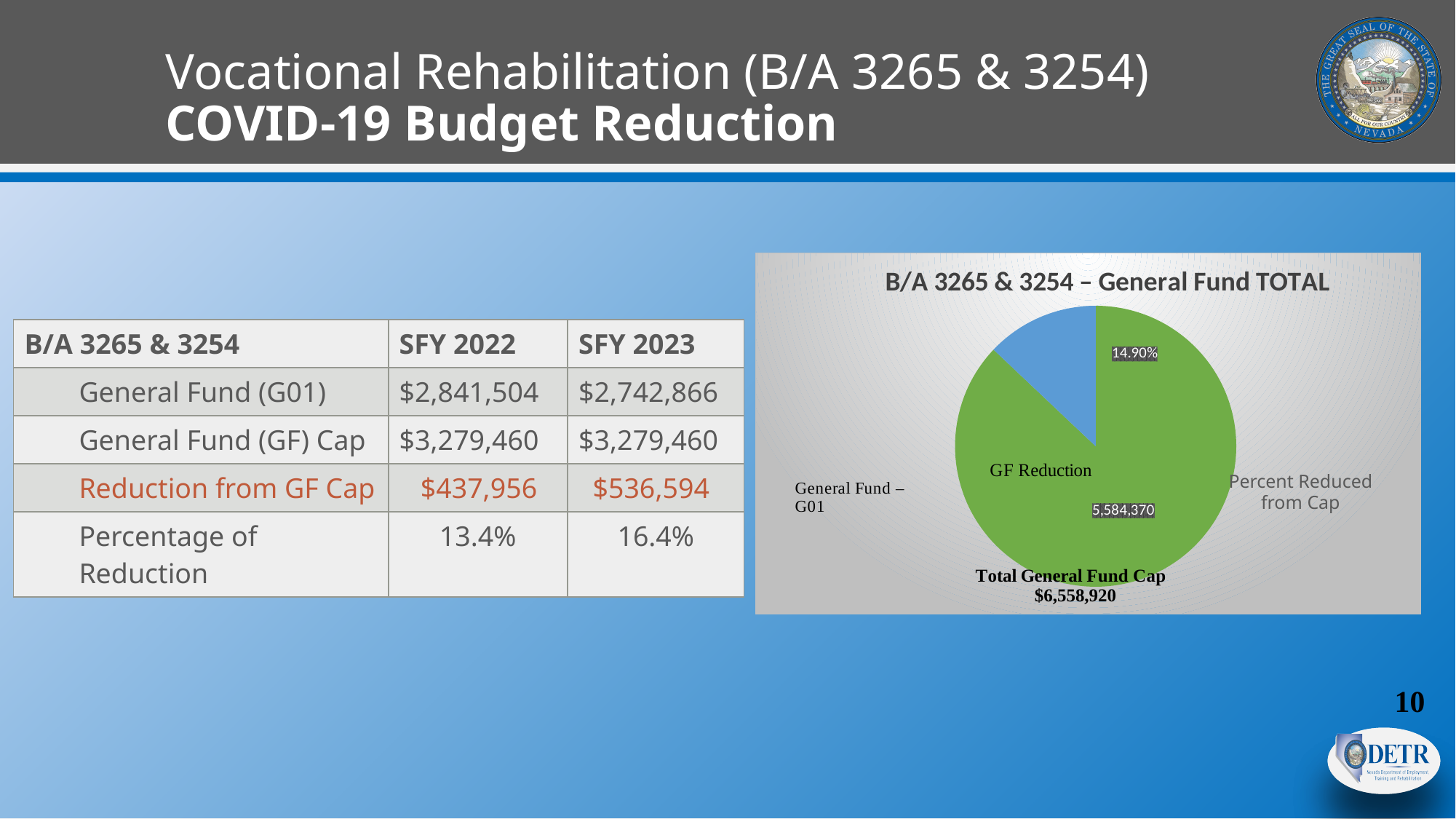
What kind of chart is shown on the slide? pie chart What percentage is shown on the smaller (blue) slice of the pie chart? 14.90% What value is printed on the large green slice of the pie chart? 5,584,370 What is the Total General Fund Cap shown below the pie chart? $6,558,920 How many slices does the pie chart have? 2 What is the title of the chart on the slide? B/A 3265 & 3254 – General Fund TOTAL